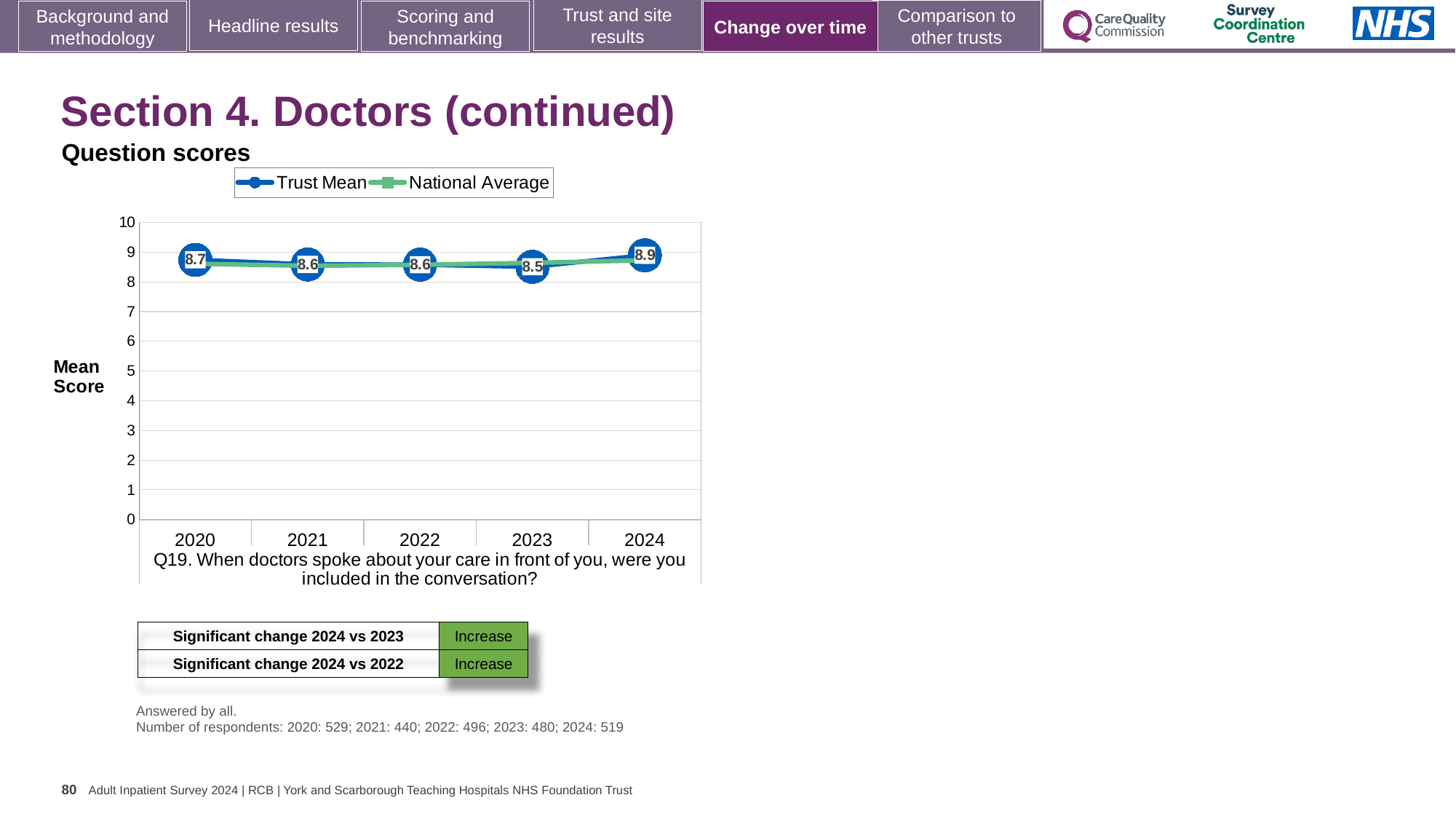
What is the difference between the Trust Mean score in 2024 and in 2023? 0.4 Is the Trust Mean score for 2021 greater or less than 5? greater How many years are shown on the x axis of the chart? 5 What kind of chart is shown on the slide? Line chart What is the Trust Mean score for 2020? 8.7 How many series does the chart legend list? 2 What is the Trust Mean score for 2023? 8.5 In which year is the Trust Mean score highest? 2024 Which is larger, the Trust Mean score in 2020 or in 2023? 2020 In which year is the Trust Mean score lowest? 2023 What is the Trust Mean score for 2024? 8.9 What is the label of the y axis of the chart? Mean Score